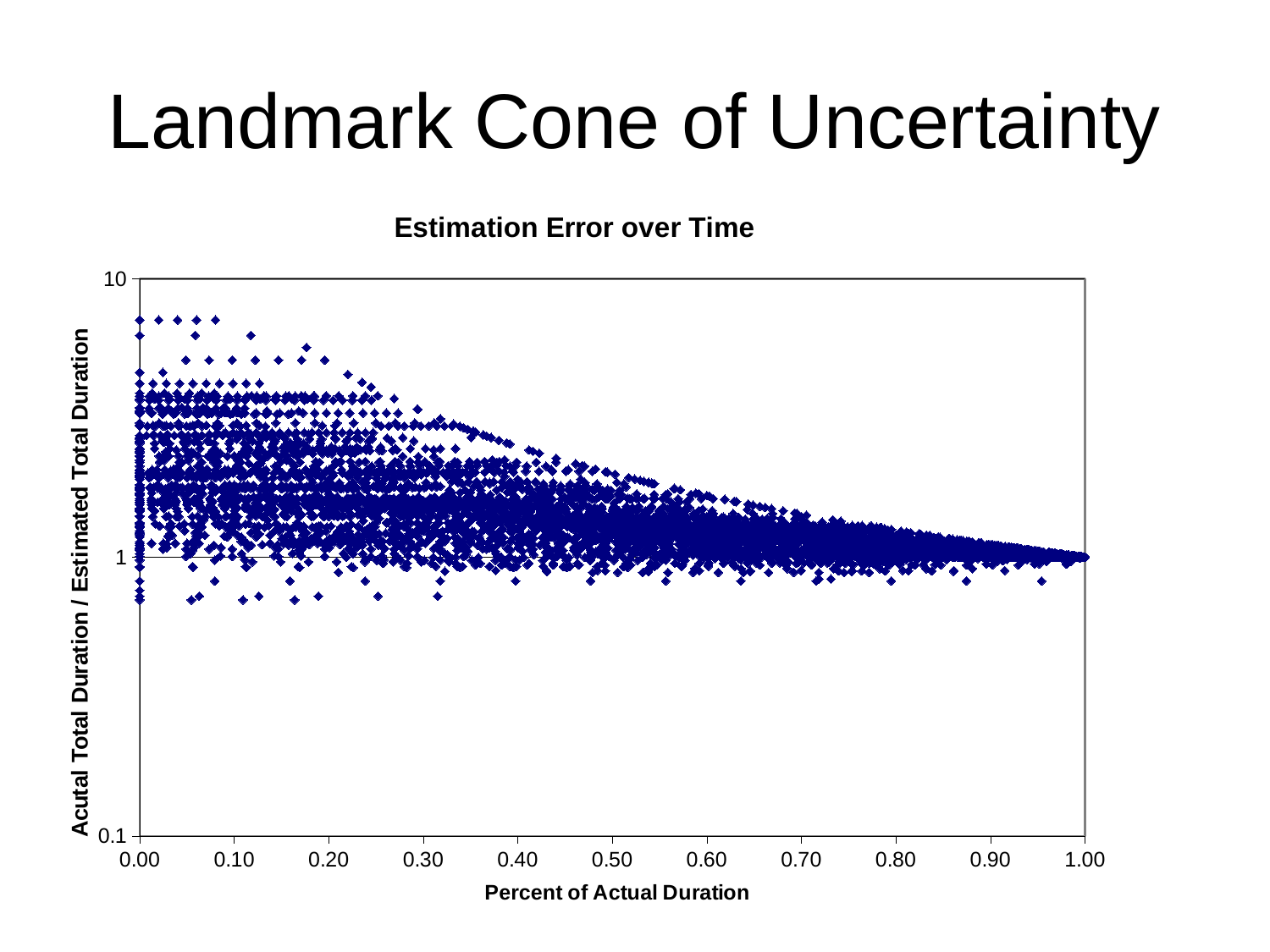
What is the highest tick value shown on the x axis? 1.00 Toward which y-axis value do the points converge as Percent of Actual Duration approaches 1.00? 1 What is the title of the chart? Estimation Error over Time What kind of chart is shown on the slide? scatter chart Are all the plotted points greater or less than 10 on the y axis? less Are the highest plotted points near 0.00 on the x axis greater or less than 1 on the y axis? greater What is the label of the x axis of the chart? Percent of Actual Duration As Percent of Actual Duration increases toward 1.00, does the spread of the plotted points widen or narrow? narrow What is the lowest tick value shown on the y axis? 0.1 What is the highest tick value shown on the y axis? 10